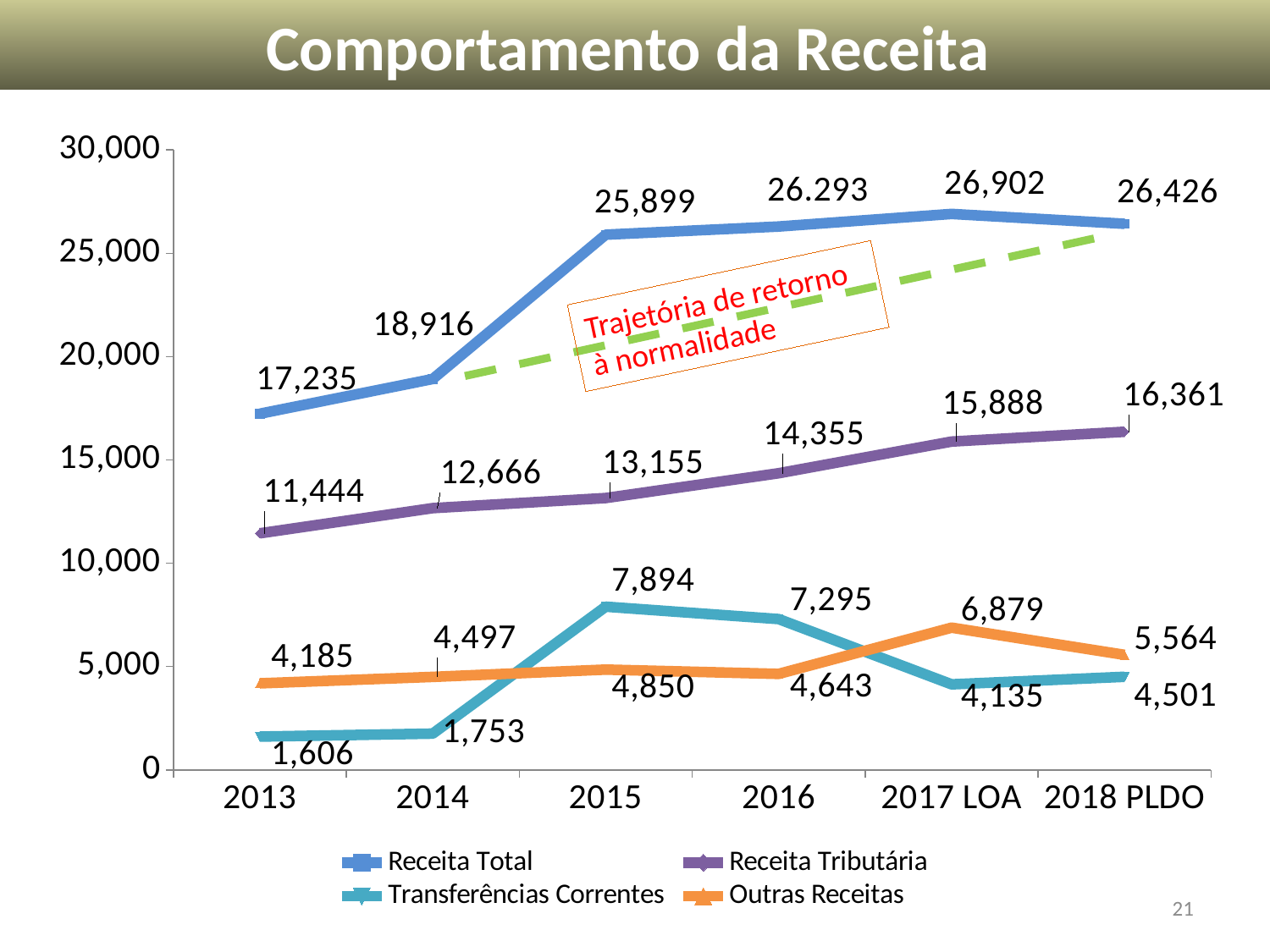
In which year is Transferências Correntes at its lowest? 2013 How many series does the legend list? 4 What is the value of Receita Tributária for 2017 LOA? 15,888 How many periods are shown on the x axis? 6 What is the value of Receita Total in 2013? 17,235 In which year does Receita Total reach its highest value? 2017 LOA What type of chart is shown on the slide? Line chart In 2016, which is larger: Transferências Correntes or Outras Receitas? Transferências Correntes By how much did Receita Tributária increase from 2013 to 2018 PLDO? 4,917 What is the value of Outras Receitas for 2018 PLDO? 5,564 What is the difference between Outras Receitas in 2017 LOA and in 2016? 2,236 What is the value of Transferências Correntes in 2015? 7,894